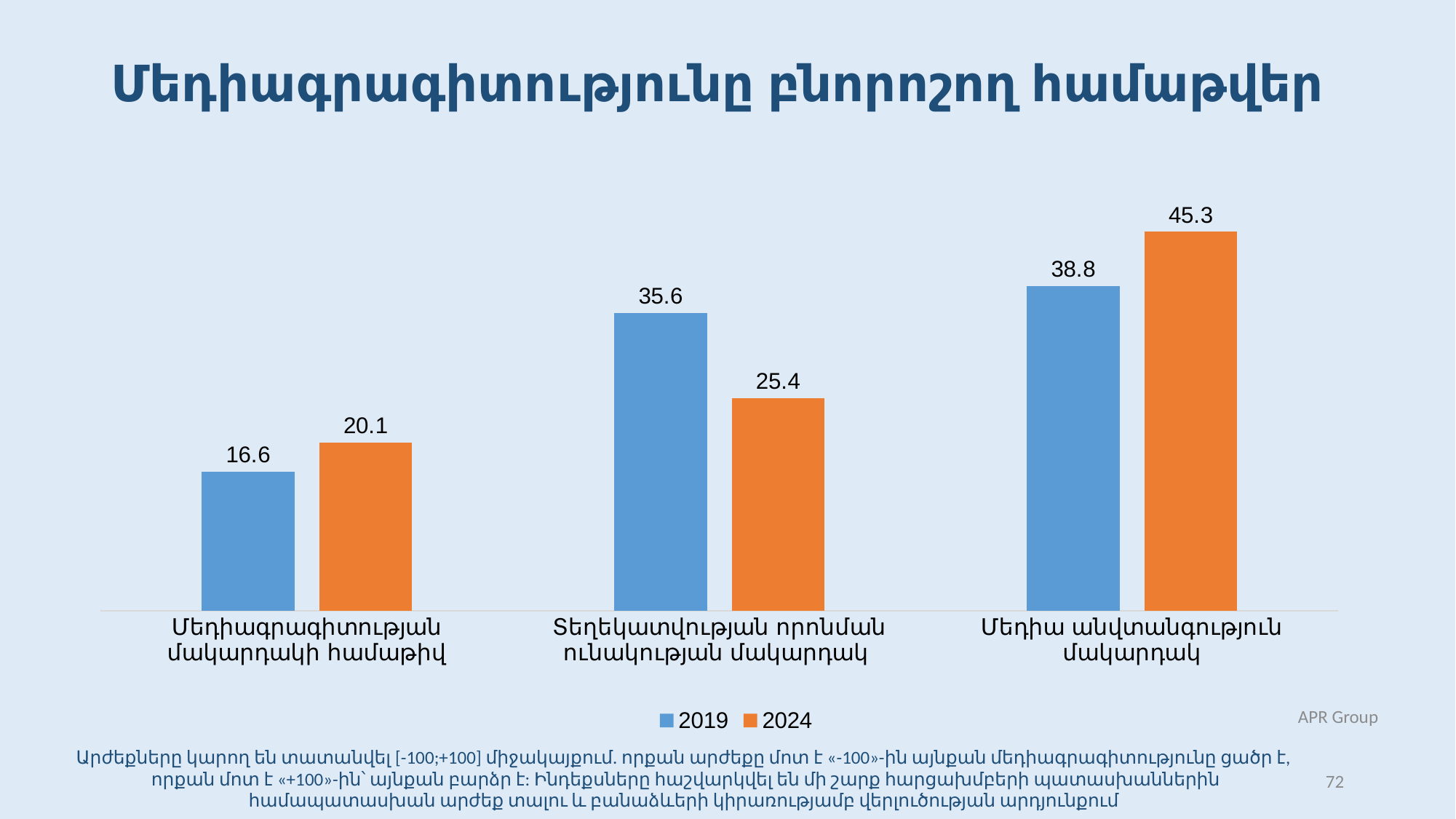
How many series does the legend list? 2 Which category has the highest 2019 value? Մեդիա անվտանգություն մակարդակ What is the 2024 value for «Մեդիա անվտանգություն մակարդակ»? 45.3 What is the difference between the 2019 and 2024 values for «Տեղեկատվության որոնման ունակության մակարդակ»? 10.2 What is the difference between the 2024 and 2019 values for «Մեդիա անվտանգություն մակարդակ»? 6.5 For «Մեդիագրագիտության մակարդակի համաթիվ», which year has the larger value, 2019 or 2024? 2024 How many categories are shown on the x axis? 3 For «Տեղեկատվության որոնման ունակության մակարդակ», which year has the larger value, 2019 or 2024? 2019 What is the 2024 value for «Տեղեկատվության որոնման ունակության մակարդակ»? 25.4 What is the 2019 value for «Մեդիագրագիտության մակարդակի համաթիվ»? 16.6 What kind of chart is shown on the slide? Bar chart Which category has the lowest 2024 value? Մեդիագրագիտության մակարդակի համաթիվ